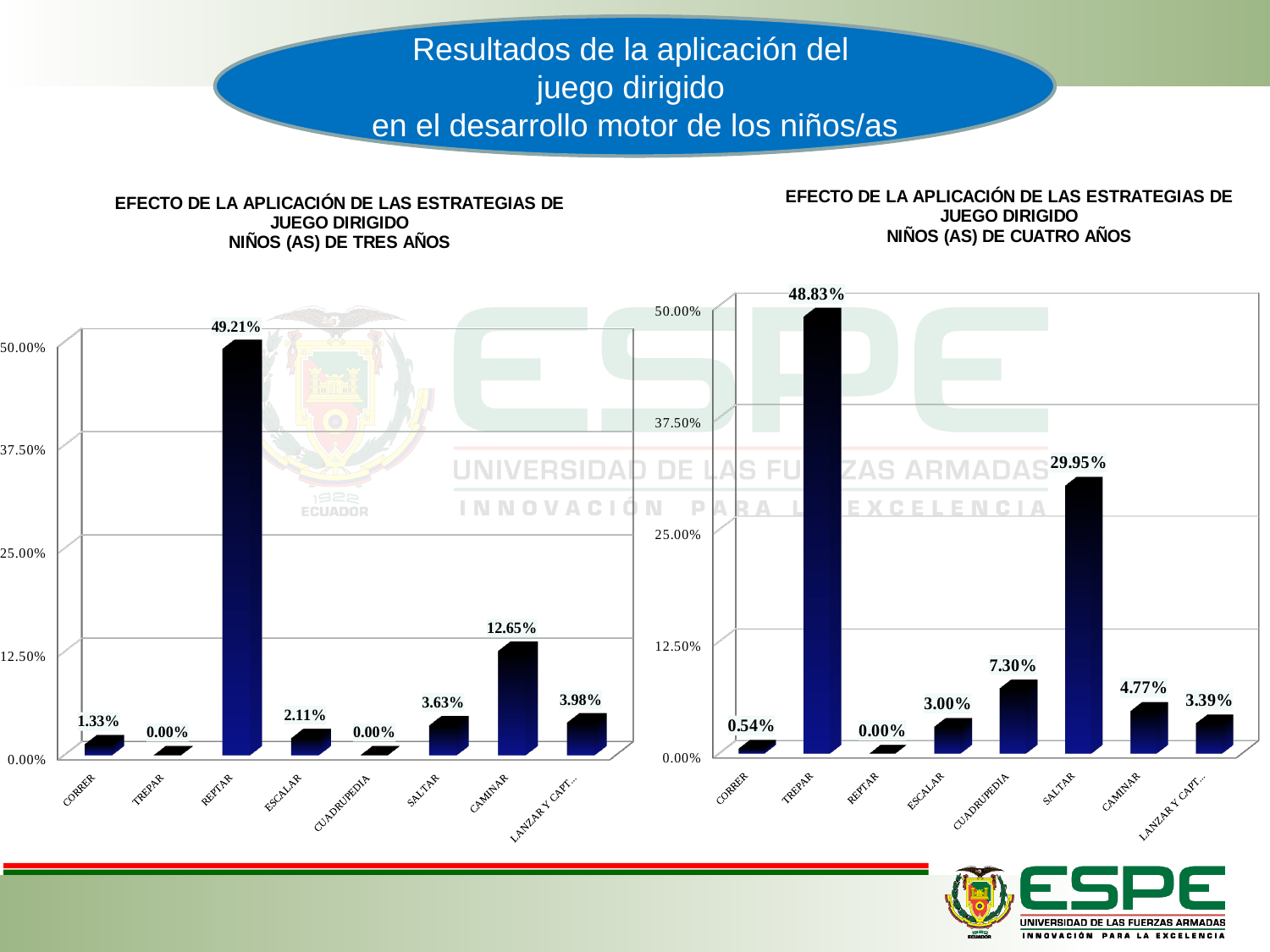
How many categories are shown on the x axis of the chart for niños (as) de tres años? 8 In the chart for niños (as) de cuatro años, is the value for SALTAR greater or less than 25.00%? greater In the chart for niños (as) de cuatro años, what is the value for CUADRUPEDIA? 7.30% In the chart for niños (as) de tres años, what is the value for CAMINAR? 12.65% In the chart for niños (as) de tres años, which is larger, the value for ESCALAR or the value for SALTAR? SALTAR In the chart for niños (as) de tres años, what is the difference between the values for CAMINAR and SALTAR? 9.02% In the chart for niños (as) de tres años, which category has the highest value? REPTAR What kind of chart is the chart for niños (as) de cuatro años? bar chart In the chart for niños (as) de cuatro años, which category has the highest value? TREPAR In the chart for niños (as) de cuatro años, what is the value for SALTAR? 29.95% In the chart for niños (as) de tres años, what is the value for REPTAR? 49.21% In the chart for niños (as) de cuatro años, what is the difference between the values for TREPAR and SALTAR? 18.88%